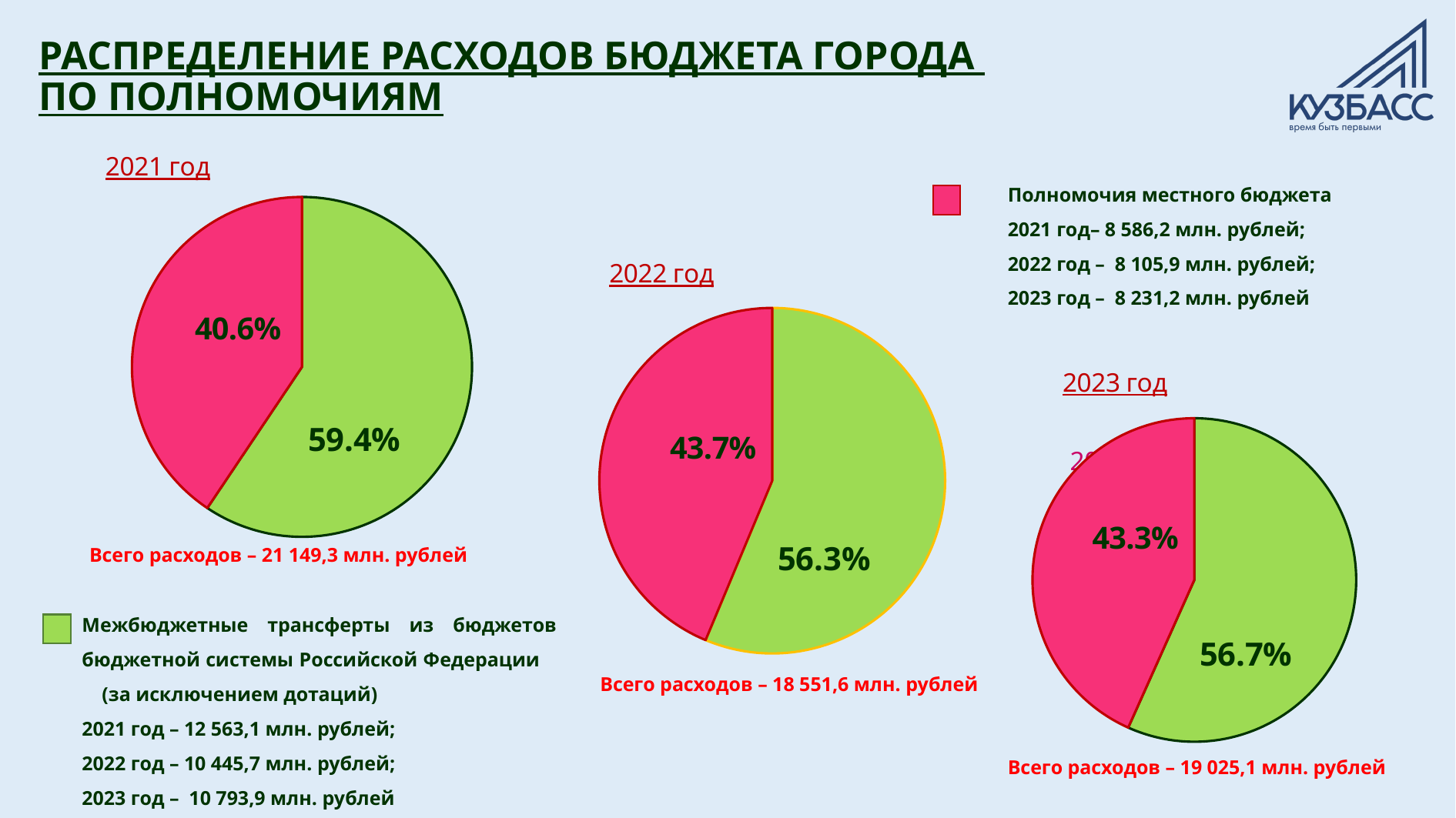
In the 2022 pie chart, what share is shown for the green slice (Межбюджетные трансферты)? 56.3% In the 2021 pie chart, which slice is larger, the pink one or the green one? the green one In the 2023 pie chart, what share is shown for the green slice (Межбюджетные трансферты)? 56.7% In the 2021 pie chart, what share is shown for the green slice (Межбюджетные трансферты)? 59.4% In the 2023 pie chart, what share is shown for the pink slice (Полномочия местного бюджета)? 43.3% In the 2022 pie chart, what is the difference in percentage points between the green slice and the pink slice? 12.6 In the 2021 pie chart, what share is shown for the pink slice (Полномочия местного бюджета)? 40.6% What type of chart is used for the 2022 год data? pie chart How many pie charts are shown on the slide? 3 How many slices does the 2023 pie chart have? 2 In the 2023 pie chart, what is the difference in percentage points between the green slice and the pink slice? 13.4 In the 2022 pie chart, what share is shown for the pink slice (Полномочия местного бюджета)? 43.7%